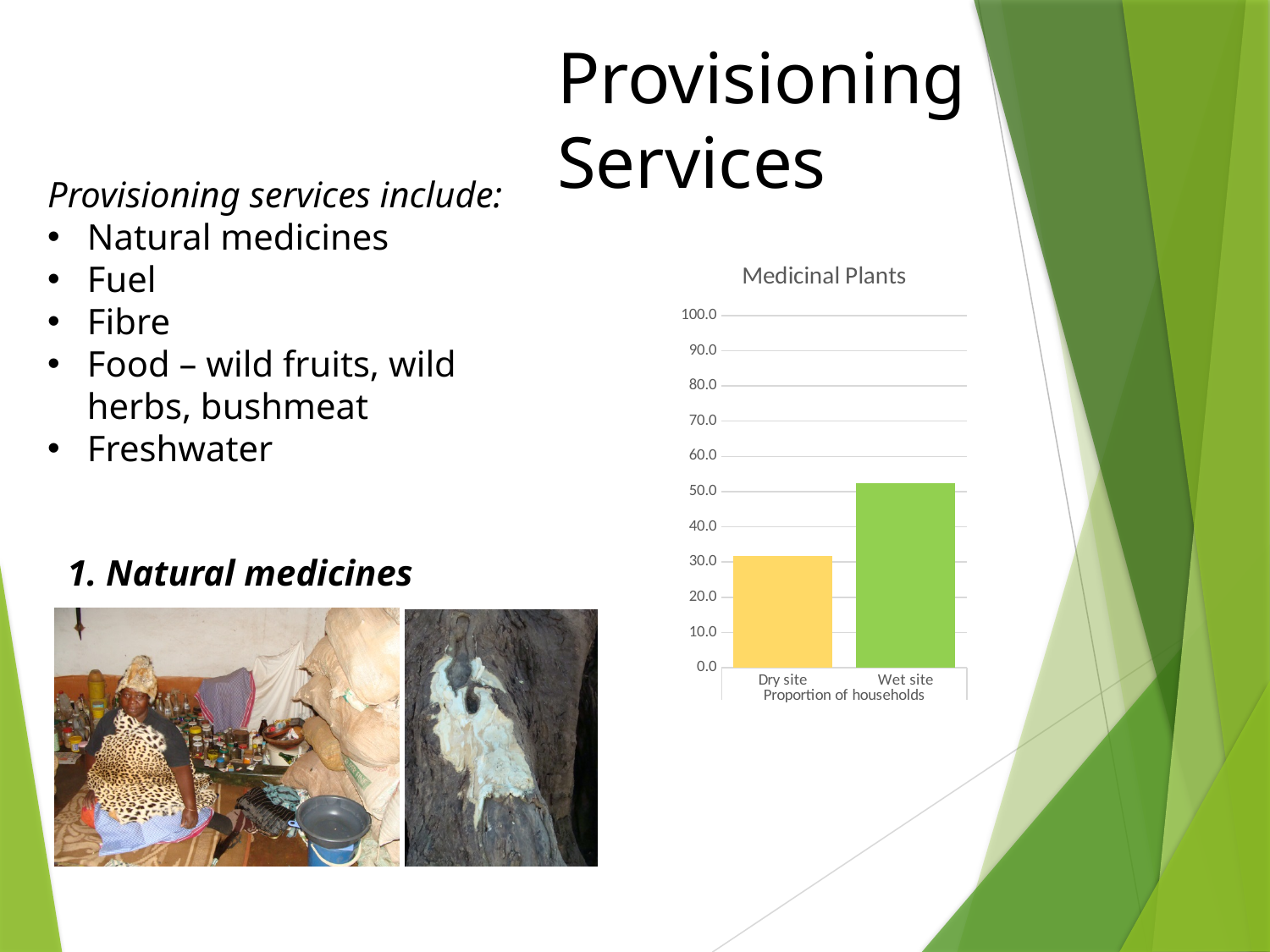
Which site has the lowest value in the Medicinal Plants chart? Dry site Is the value for Wet site greater or less than 60.0? less Is the value for Wet site greater or less than 50.0? greater What is the title of the chart? Medicinal Plants Which site has the highest value in the Medicinal Plants chart? Wet site Do the values rise or fall from Dry site to Wet site? rise What is the x-axis label of the Medicinal Plants chart? Proportion of households Which is larger in the Medicinal Plants chart, Dry site or Wet site? Wet site Is the value for Dry site greater or less than 40.0? less How many categories are plotted in the Medicinal Plants chart? 2 What kind of chart is shown on the slide? bar chart